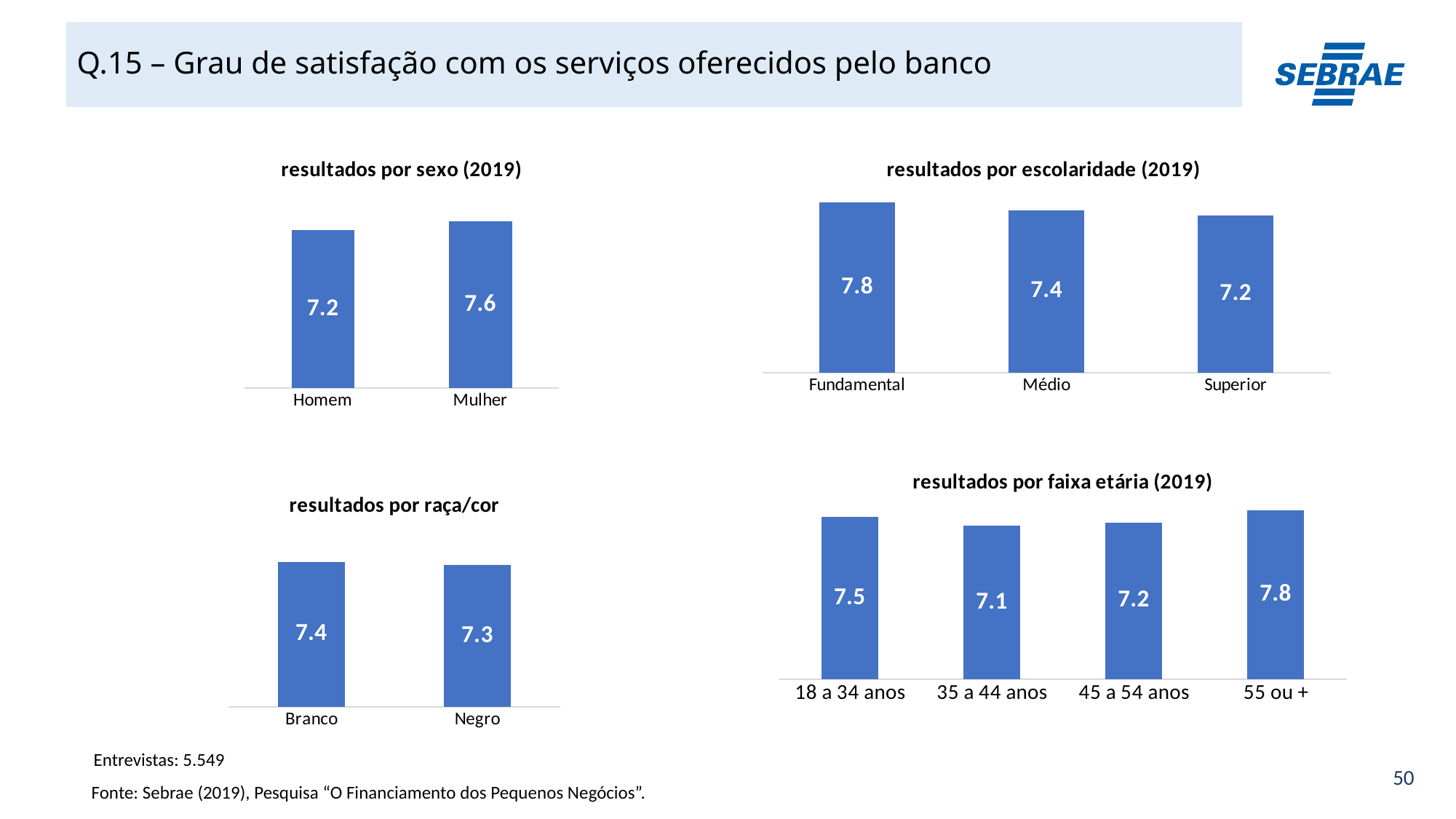
What kind of chart is the 'resultados por faixa etária (2019)' chart? bar chart In the 'resultados por sexo (2019)' chart, what is the value for Mulher? 7.6 In the 'resultados por faixa etária (2019)' chart, what is the difference between the values for 55 ou + and 18 a 34 anos? 0.3 In the 'resultados por faixa etária (2019)' chart, which age group has the lowest value? 35 a 44 anos In the 'resultados por escolaridade (2019)' chart, which category has the highest value? Fundamental In the 'resultados por raça/cor' chart, which is larger, the value for Branco or Negro? Branco In the 'resultados por escolaridade (2019)' chart, how many categories are shown? 3 In the 'resultados por sexo (2019)' chart, what is the difference between the values for Mulher and Homem? 0.4 In the 'resultados por raça/cor' chart, what is the value for Negro? 7.3 In the 'resultados por faixa etária (2019)' chart, what is the value for 55 ou +? 7.8 In the 'resultados por escolaridade (2019)' chart, do the values rise or fall from Fundamental to Superior? fall In the 'resultados por escolaridade (2019)' chart, what is the value for Médio? 7.4